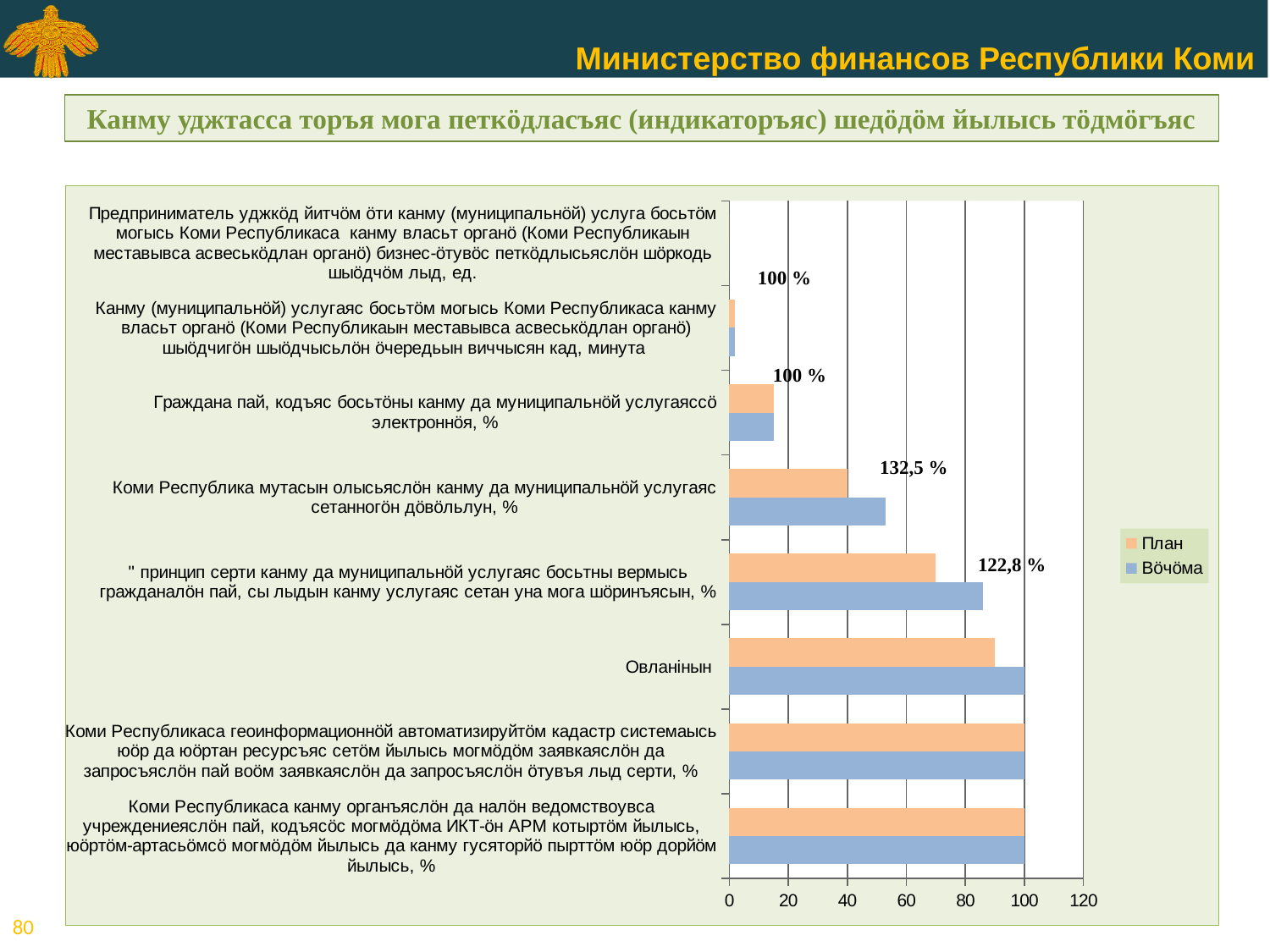
Is the План value for Овланiнын greater or less than 80? greater For 'Коми Республика мутасын олысьяслöн канму да муниципальнöй услугаяс сетанногöн дöвöльлун, %', which series has the larger value, План or Вöчöма? Вöчöма For 'принцип серти канму да муниципальнöй услугаяс босьтны вермысь гражданалöн пай...', which series has the larger value, План or Вöчöма? Вöчöма How many series does the legend list? 2 How many categories are plotted on the chart? 8 Is the План value for 'Коми Республика мутасын олысьяслöн канму да муниципальнöй услугаяс сетанногöн дöвöльлун, %' greater or less than 60? less Is the Вöчöма value for 'принцип серти канму да муниципальнöй услугаяс босьтны вермысь гражданалöн пай...' greater or less than 80? greater What are the two series named in the legend? План and Вöчöма What kind of chart is shown on the slide? bar chart What is the highest value shown on the horizontal axis? 120 What is the План value for 'Коми Республикаса геоинформационнöй автоматизируйтöм кадастр системаысь...' category? 100